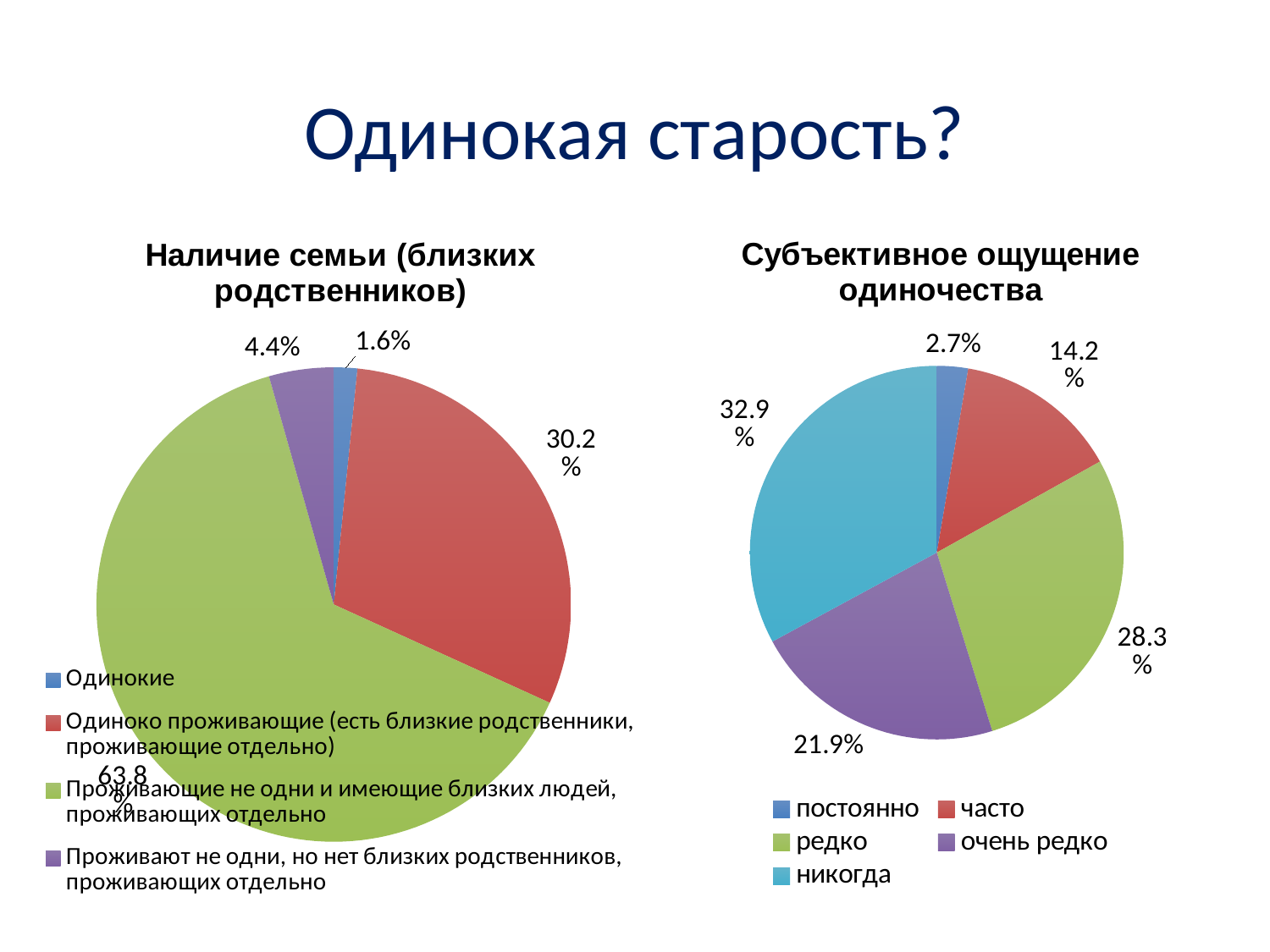
In the chart titled "Наличие семьи (близких родственников)", which category has the smallest slice? Одинокие In the chart titled "Субъективное ощущение одиночества", what is the value for "часто"? 14.2% In the chart titled "Наличие семьи (близких родственников)", what share of the pie is "Одинокие"? 1.6% In the chart titled "Наличие семьи (близких родственников)", which category has the largest slice? Проживающие не одни и имеющие близких людей, проживающих отдельно In the chart titled "Наличие семьи (близких родственников)", how many categories does the legend list? 4 What type of chart is the chart on the right of the slide? Pie chart In the chart titled "Субъективное ощущение одиночества", which category has the smallest share? постоянно In the chart titled "Субъективное ощущение одиночества", which is larger: "редко" or "очень редко"? редко In the chart titled "Субъективное ощущение одиночества", what is the difference between "никогда" and "постоянно"? 30.2% In the chart titled "Наличие семьи (близких родственников)", what is the value for "Одиноко проживающие (есть близкие родственники, проживающие отдельно)"? 30.2% In the chart titled "Субъективное ощущение одиночества", what is the value for "никогда"? 32.9% In the chart titled "Субъективное ощущение одиночества", how many slices does the pie have? 5